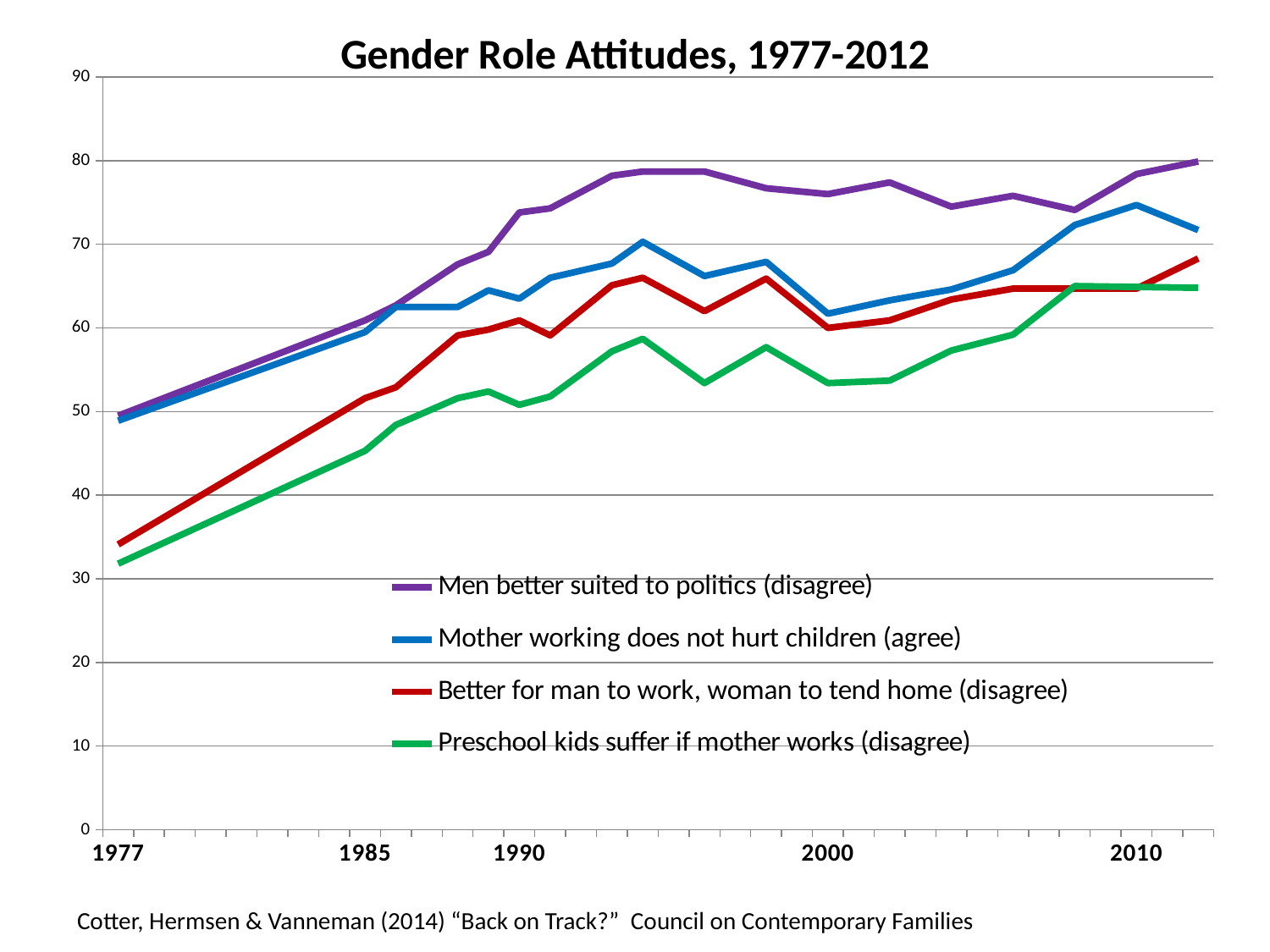
Which series has the highest value in 2010? Men better suited to politics (disagree) Does the line for "Preschool kids suffer if mother works (disagree)" rise or fall between 1977 and 1985? rise Is the value for "Men better suited to politics (disagree)" in 1977 greater or less than 40? greater What colour is the line for "Better for man to work, woman to tend home (disagree)"? red Which series has the lowest value in 1990? Preschool kids suffer if mother works (disagree) Is the value for "Mother working does not hurt children (agree)" in 2010 greater or less than 70? greater What is the title of the chart? Gender Role Attitudes, 1977-2012 In 1990, which series has the larger value: "Men better suited to politics (disagree)" or "Mother working does not hurt children (agree)"? Men better suited to politics (disagree) What kind of chart is shown on the slide? line chart Is the value for "Preschool kids suffer if mother works (disagree)" in 1977 greater or less than 40? less How many series does the legend list? 4